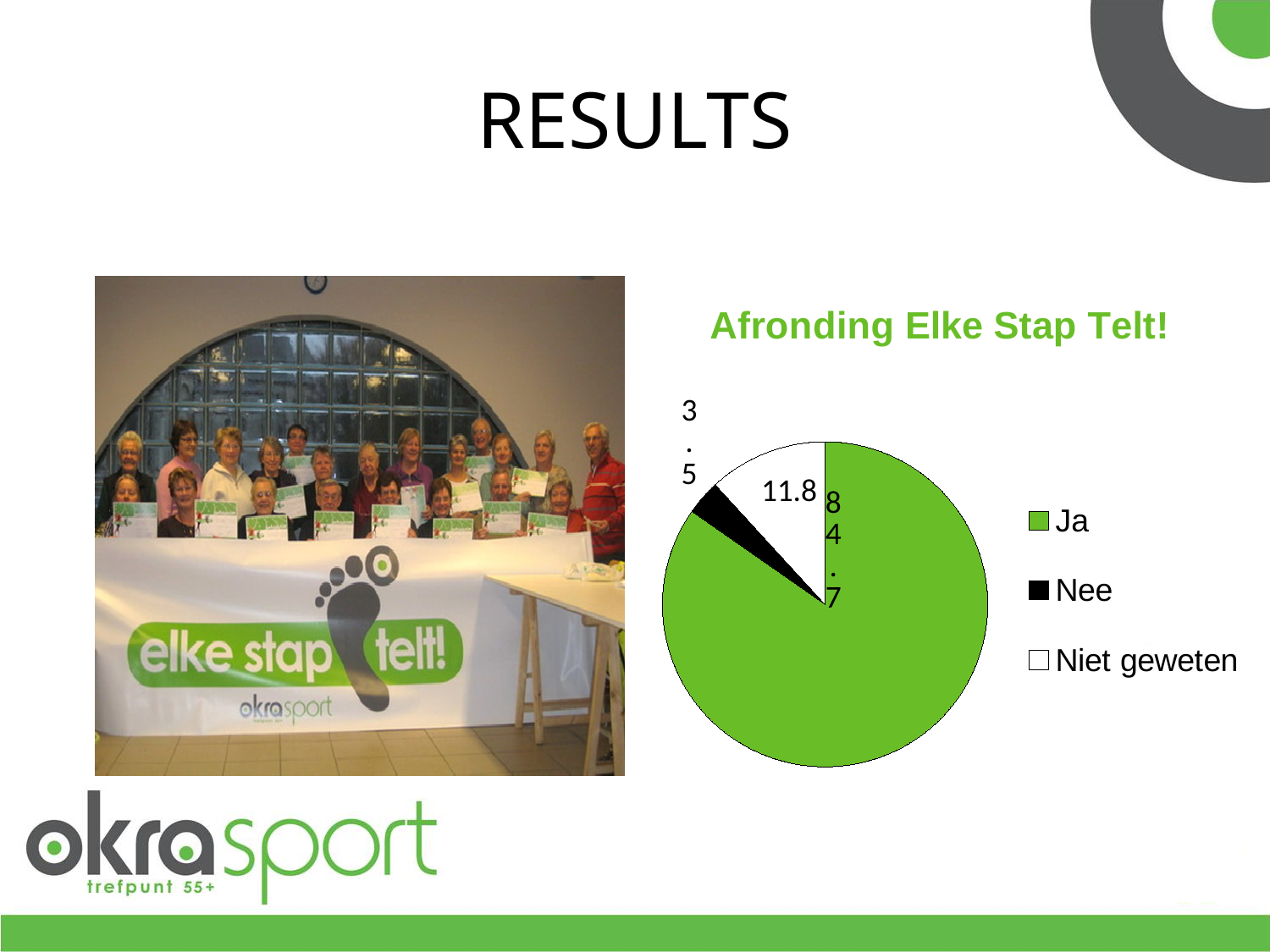
What is the value for Nee? 3.5 What is the difference between the values for Niet geweten and Nee? 8.3 What is the title of the chart? Afronding Elke Stap Telt! Which category has the largest slice? Ja Which is larger, Nee or Niet geweten? Niet geweten What is the value for Niet geweten? 11.8 How many entries does the legend list? 3 What kind of chart is shown on the slide? pie chart Which category has the smallest slice? Nee How many slices does the pie chart have? 3 What is the value for Ja? 84.7 Which colour represents Nee in the pie chart? black